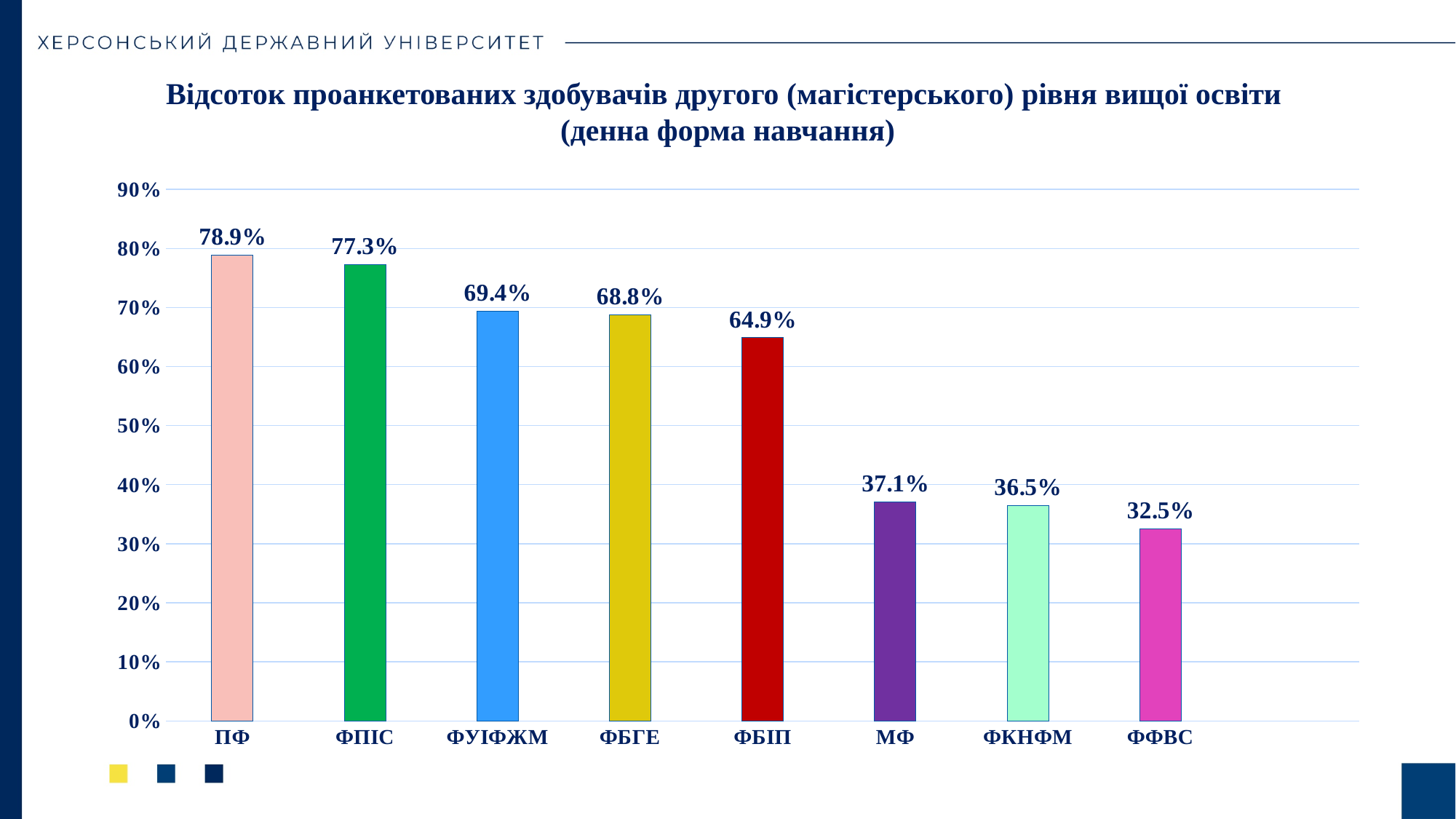
What is the value for ФКНФМ? 36.5% How many categories are shown on the x axis? 8 Is the value for МФ greater or less than 40%? less What is the value for ФБІП? 64.9% What is the difference between the values for ФУІФЖМ and ФБГЕ? 0.6% Do the values rise or fall from left to right along the x axis? fall What kind of chart is shown on the slide? bar chart Which is larger, the value for ФПІС or the value for ФБІП? ФПІС What is the value for ПФ? 78.9% Which category has the lowest value? ФФВС What is the difference between the values for ПФ and ФФВС? 46.4% Which category has the highest value? ПФ